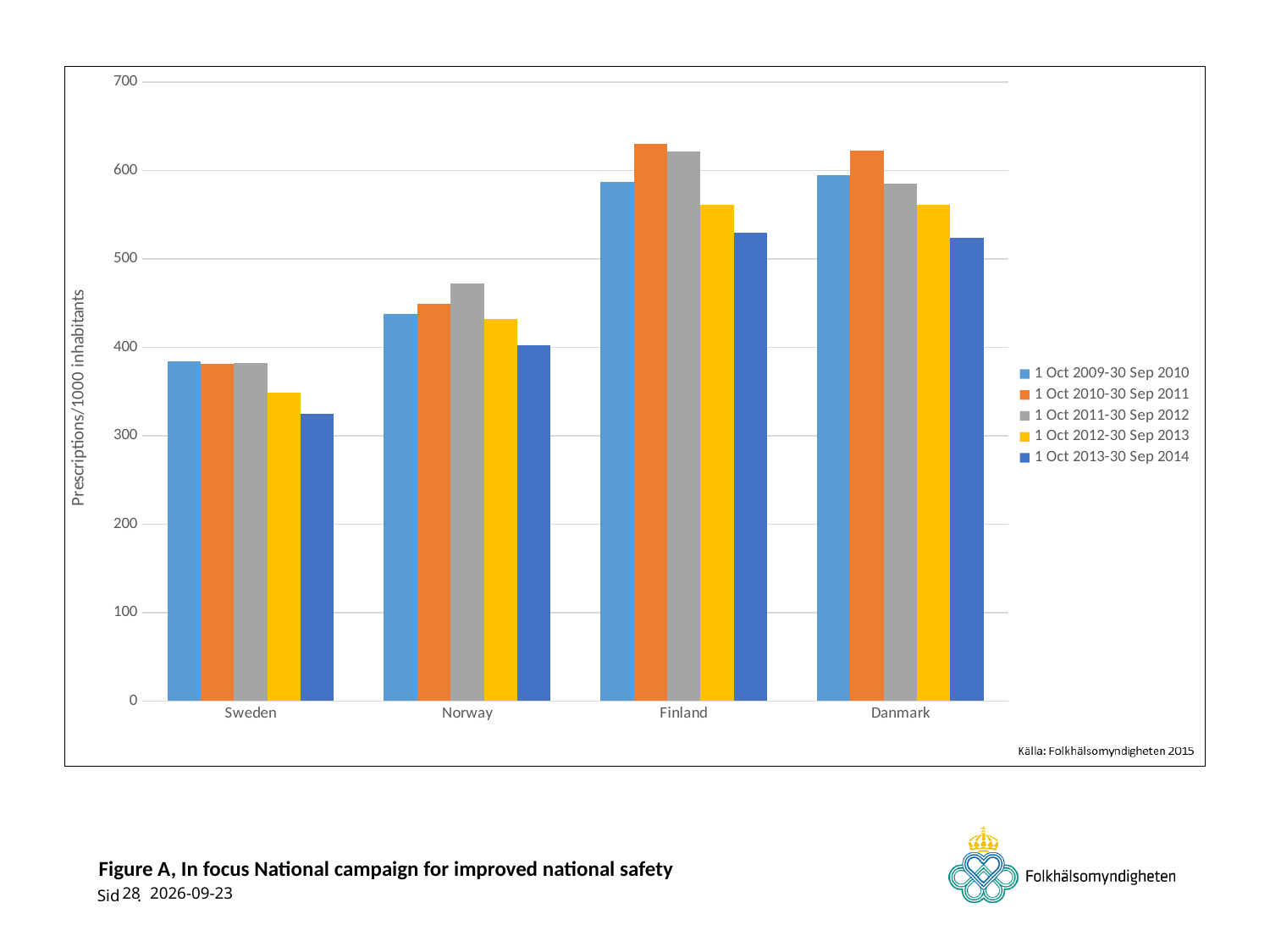
How many series does the legend list? 5 Which is larger: the value for Sweden or for Norway in 1 Oct 2009-30 Sep 2010? Norway What kind of chart is shown on the slide? bar chart What is the label on the y axis of the chart? Prescriptions/1000 inhabitants Which country has the lowest values across all periods? Sweden For Norway, which period has the lowest value? 1 Oct 2013-30 Sep 2014 Does the value for Finland rise or fall from 1 Oct 2010-30 Sep 2011 to 1 Oct 2013-30 Sep 2014? fall How many countries are shown on the x axis of the chart? 4 Is the value for Danmark in 1 Oct 2013-30 Sep 2014 greater or less than 500? greater For Norway, which period has the highest value? 1 Oct 2011-30 Sep 2012 Is the value for Finland in 1 Oct 2010-30 Sep 2011 greater or less than 600? greater Is the value for Sweden in 1 Oct 2013-30 Sep 2014 greater or less than 400? less